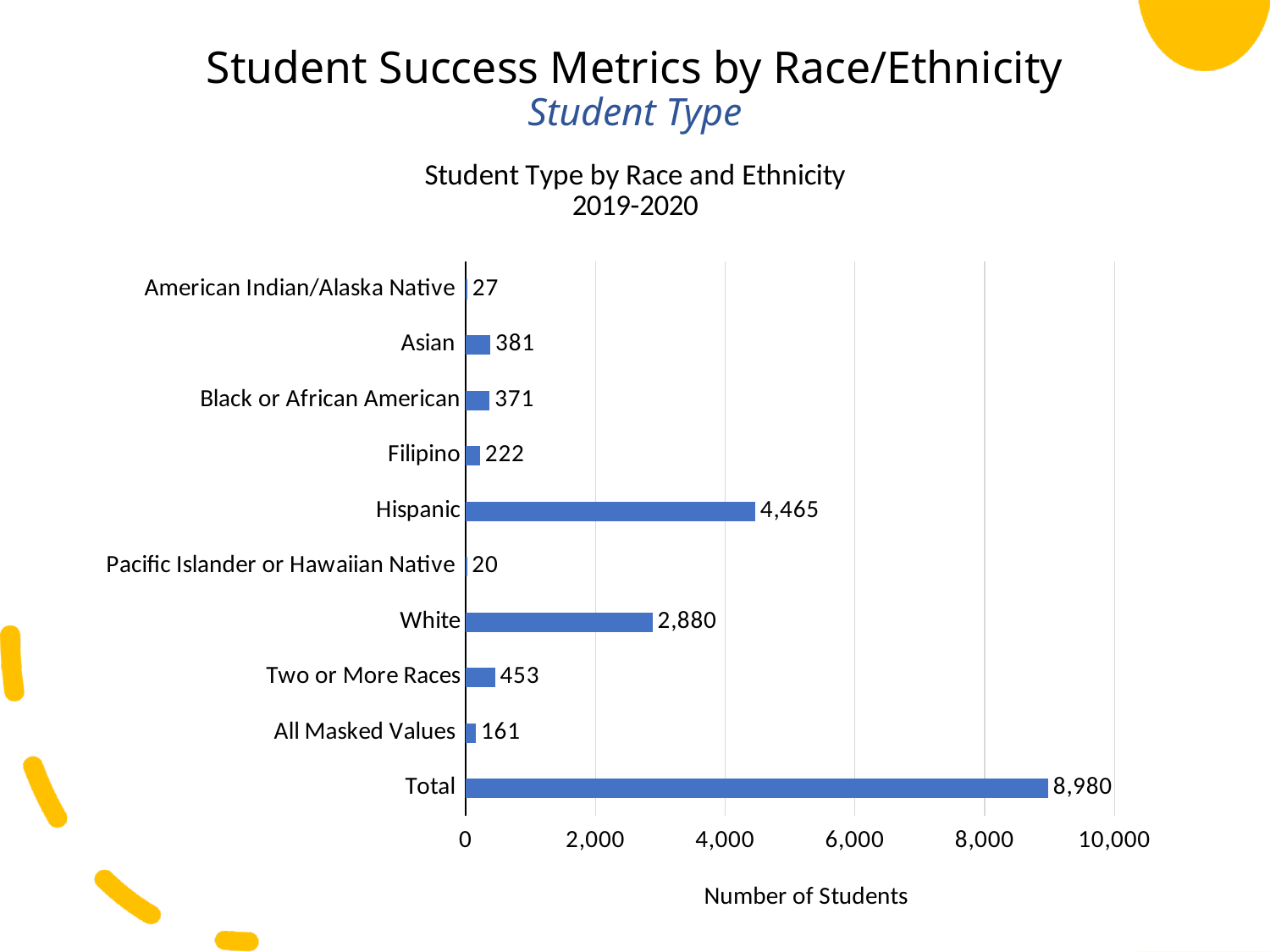
What is the number of students for Two or More Races? 453 What is the difference between the Asian and Black or African American values? 10 Which is larger, the value for Filipino or the value for Two or More Races? Two or More Races What type of chart is shown on the slide? Bar chart What is the number of students for Hispanic? 4,465 What is the label of the horizontal axis? Number of Students What is the value shown for All Masked Values? 161 How many categories (bars) are shown in the chart? 10 What is the difference between the Hispanic and White values? 1,585 Which category has the lowest number of students? Pacific Islander or Hawaiian Native Excluding the Total bar, which category has the highest number of students? Hispanic Is the value for White greater or less than 2,000? greater